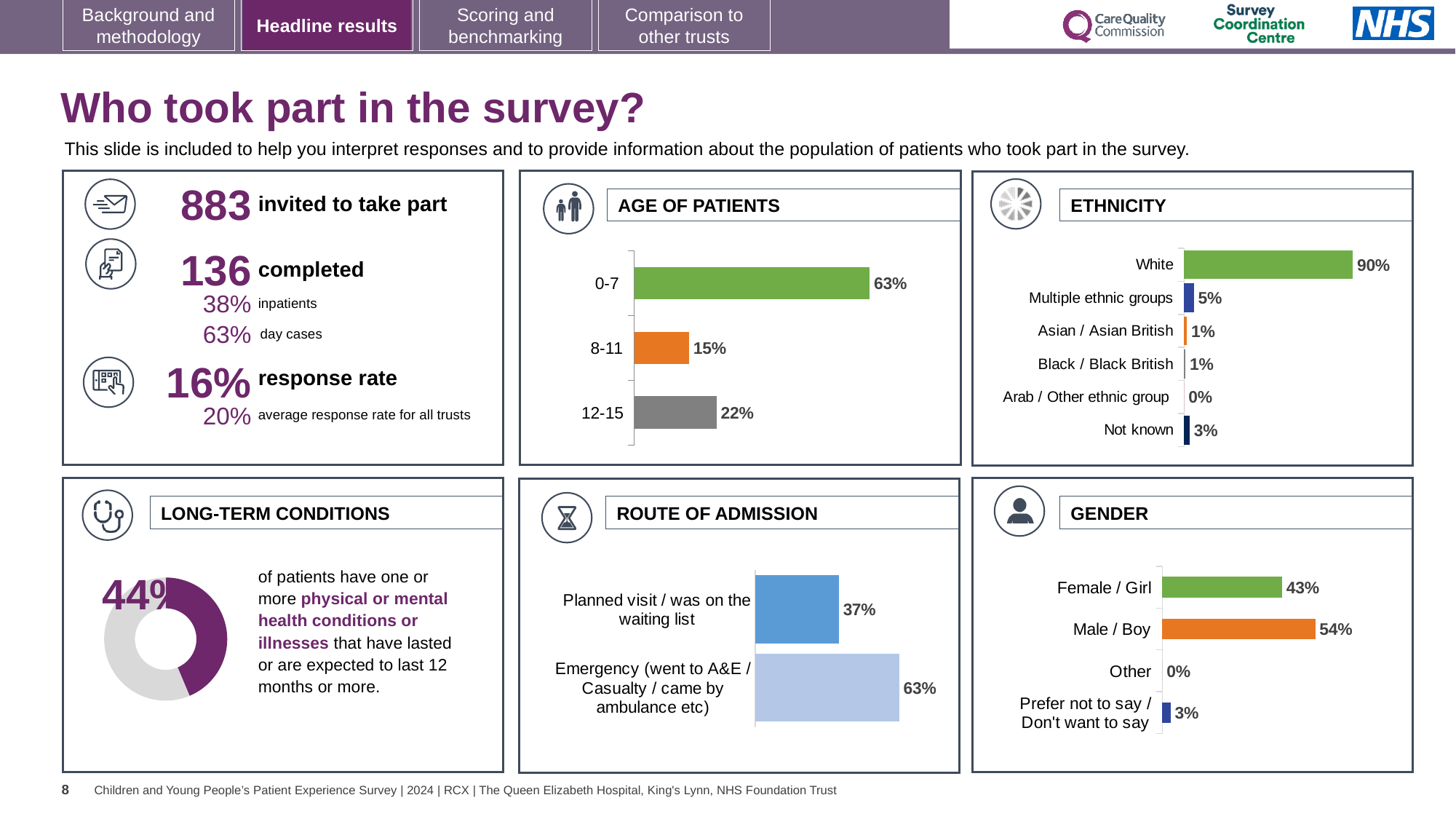
In the ETHNICITY chart, how many ethnicity categories are shown? 6 In the GENDER chart, what is the difference between Male / Boy and Female / Girl? 11% In the AGE OF PATIENTS chart, what is the difference between the 12-15 and 8-11 percentages? 7% In the ROUTE OF ADMISSION chart, what percentage of patients came via Emergency (went to A&E / Casualty / came by ambulance etc)? 63% In the AGE OF PATIENTS chart, which age group has the lowest percentage? 8-11 In the ETHNICITY chart, what is the value for Not known? 3% In the LONG-TERM CONDITIONS chart, what percentage of patients have one or more physical or mental health conditions or illnesses? 44% In the ETHNICITY chart, what percentage of patients were White? 90% In the GENDER chart, what percentage of patients were Male / Boy? 54% What kind of chart is used in the LONG-TERM CONDITIONS panel? Doughnut chart In the ROUTE OF ADMISSION chart, which route has the larger value: Planned visit / was on the waiting list or Emergency? Emergency (went to A&E / Casualty / came by ambulance etc) In the AGE OF PATIENTS chart, what percentage of patients were aged 0-7? 63%